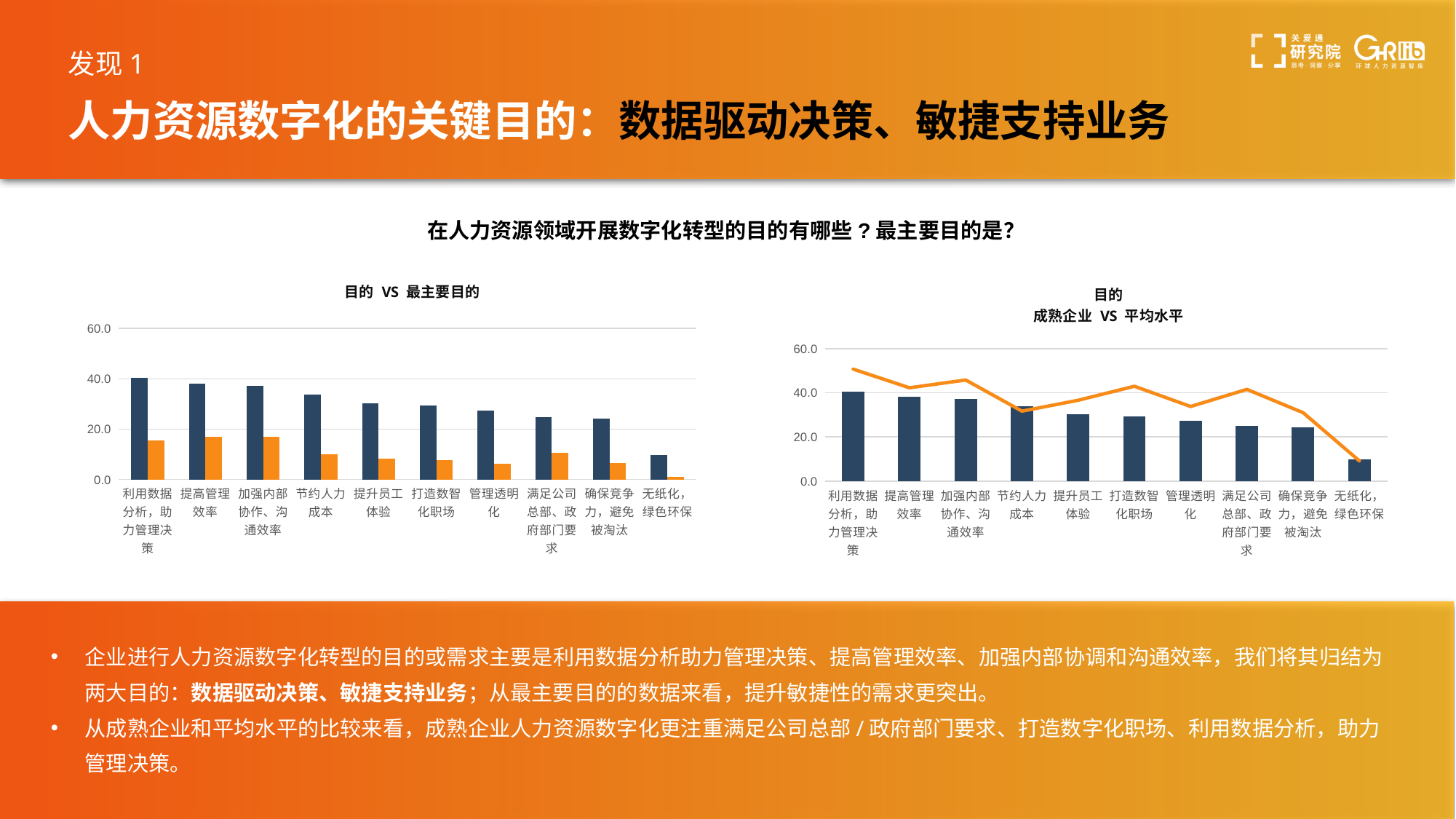
In the left chart (目的 VS 最主要目的), do the dark blue bars generally rise or fall from left to right along the x axis? fall What is the title of the right chart? 目的 成熟企业 VS 平均水平 In the left chart (目的 VS 最主要目的), is the orange bar for 提高管理效率 greater or less than 20.0? less In the right chart (目的 成熟企业 VS 平均水平), how many categories are shown on the x axis? 10 In the left chart (目的 VS 最主要目的), which is larger for 节约人力成本: the dark blue bar or the orange bar? the dark blue bar In the left chart (目的 VS 最主要目的), is the dark blue bar for 提高管理效率 greater or less than 40.0? less In the right chart (目的 成熟企业 VS 平均水平), is the orange line value for 利用数据分析，助力管理决策 greater or less than 40.0? greater In the right chart (目的 成熟企业 VS 平均水平), which is higher for 打造数智化职场: the orange line point or the dark blue bar? the orange line point What kind of chart is the left chart titled 目的 VS 最主要目的? bar chart In the left chart (目的 VS 最主要目的), which category has the shortest dark blue bar? 无纸化，绿色环保 In the left chart (目的 VS 最主要目的), how many categories are shown on the x axis? 10 In the left chart (目的 VS 最主要目的), which category has the tallest dark blue bar? 利用数据分析，助力管理决策